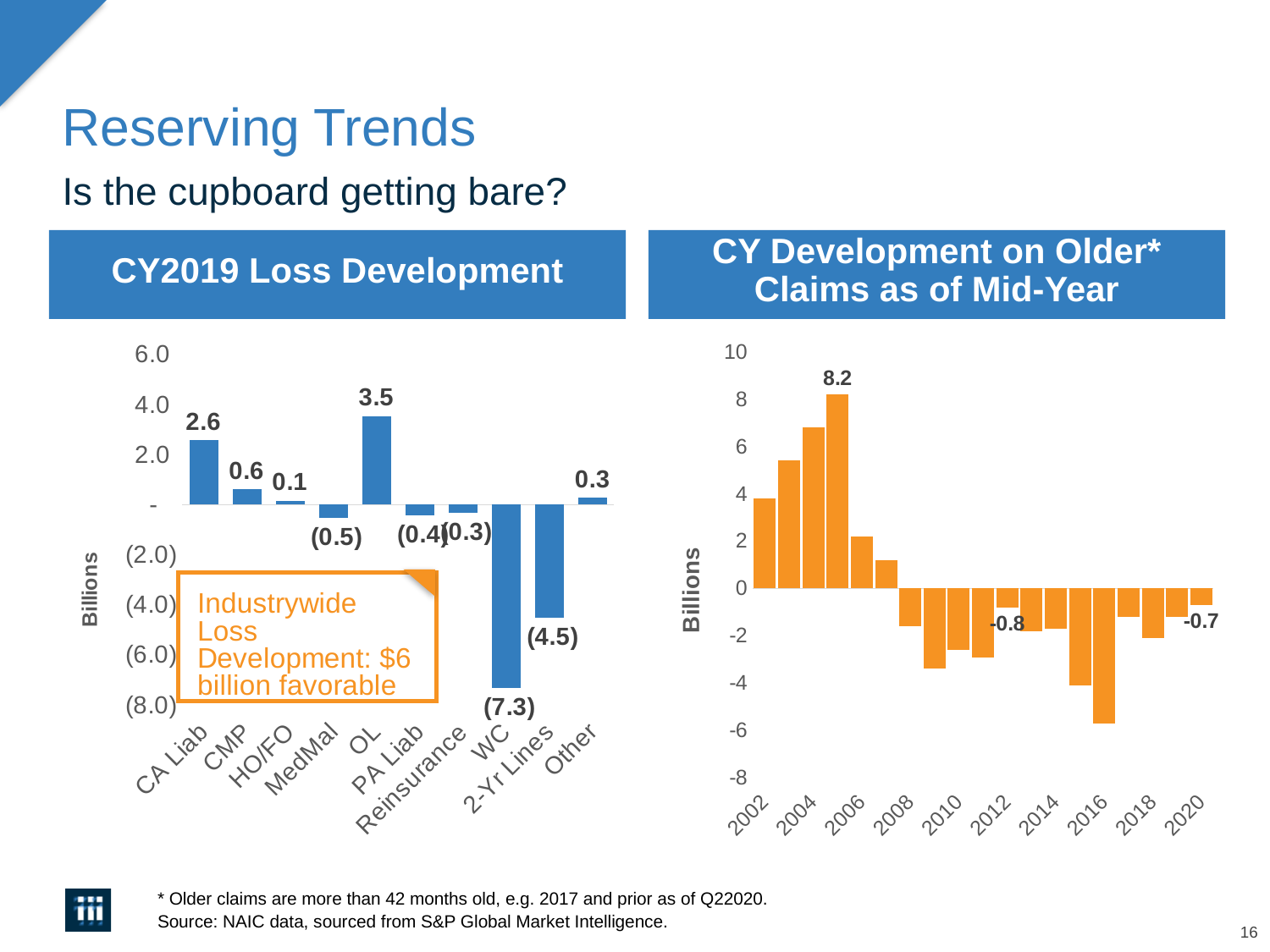
In the CY2019 Loss Development chart, what is the difference between the values for CA Liab and CMP? 2.0 In the CY2019 Loss Development chart, what is the value for OL? 3.5 In the CY Development on Older Claims as of Mid-Year chart, what is the highest value labeled? 8.2 In the CY2019 Loss Development chart, which category has the lowest value? WC According to the annotation on the CY2019 Loss Development chart, what was the industrywide loss development? $6 billion favorable In the CY2019 Loss Development chart, which is larger, the value for CA Liab or the value for OL? OL What kind of chart is the CY Development on Older Claims as of Mid-Year chart? Bar chart In the CY Development on Older Claims as of Mid-Year chart, is the value for 2016 greater or less than -4? less How many categories are shown in the CY2019 Loss Development chart? 10 In the CY Development on Older Claims as of Mid-Year chart, what is the value for 2020? -0.7 In the CY2019 Loss Development chart, which category has the highest value? OL In the CY2019 Loss Development chart, what is the value for WC? (7.3)